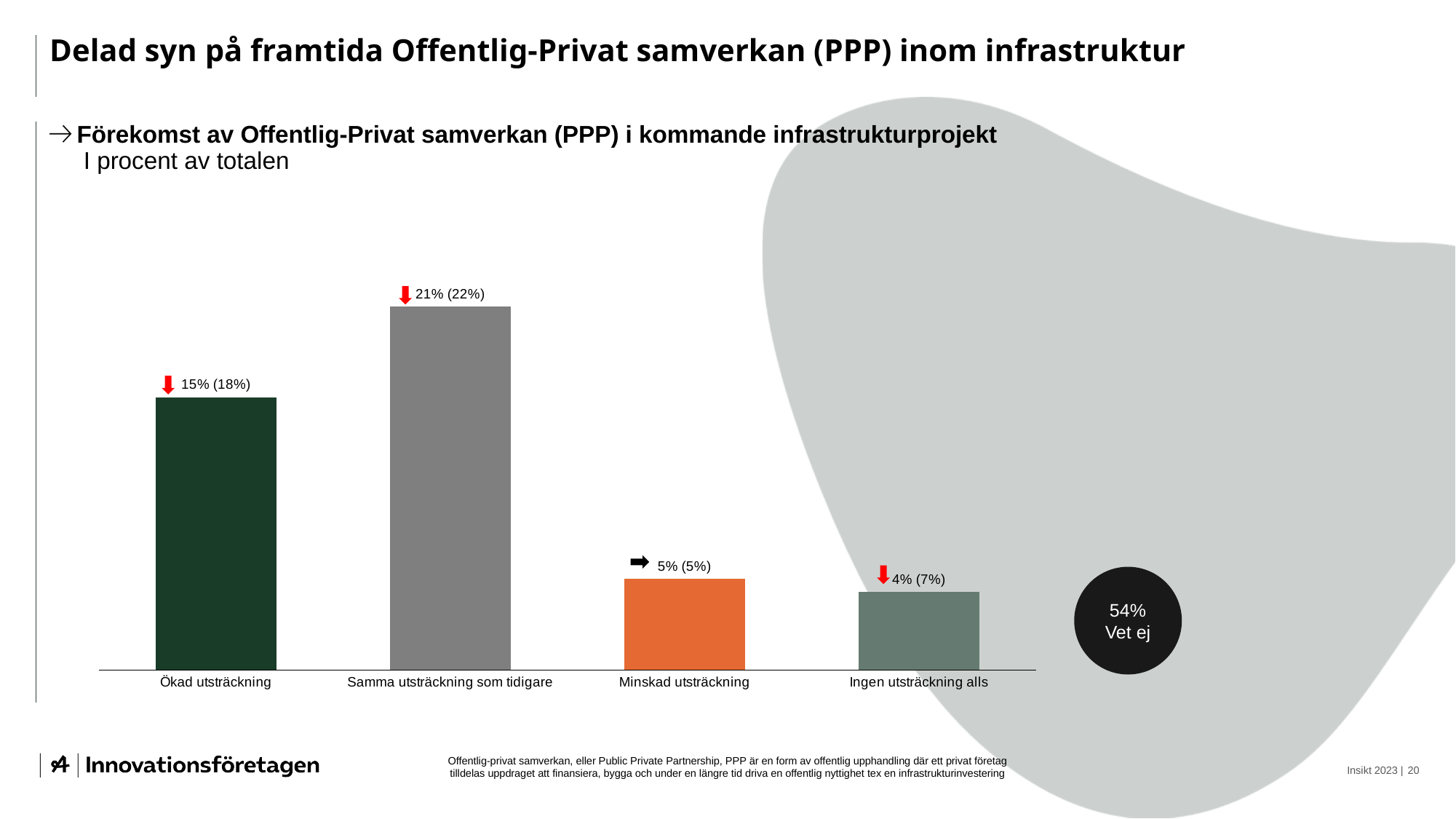
What is the value for Minskad utsträckning? 5% What percentage answered 'Vet ej' according to the circle on the slide? 54% What is the value for Ökad utsträckning? 15% What kind of chart is shown on the slide? Bar chart What was the previous value (shown in parentheses) for Ökad utsträckning? 18% What is the difference between the values for Samma utsträckning som tidigare and Ökad utsträckning? 6% Which category has the lowest value? Ingen utsträckning alls Which category has the highest value? Samma utsträckning som tidigare How many categories are shown on the x axis of the bar chart? 4 Which is larger, the value for Ökad utsträckning or the value for Minskad utsträckning? Ökad utsträckning What is the value for Samma utsträckning som tidigare? 21% What is the value for Ingen utsträckning alls? 4%